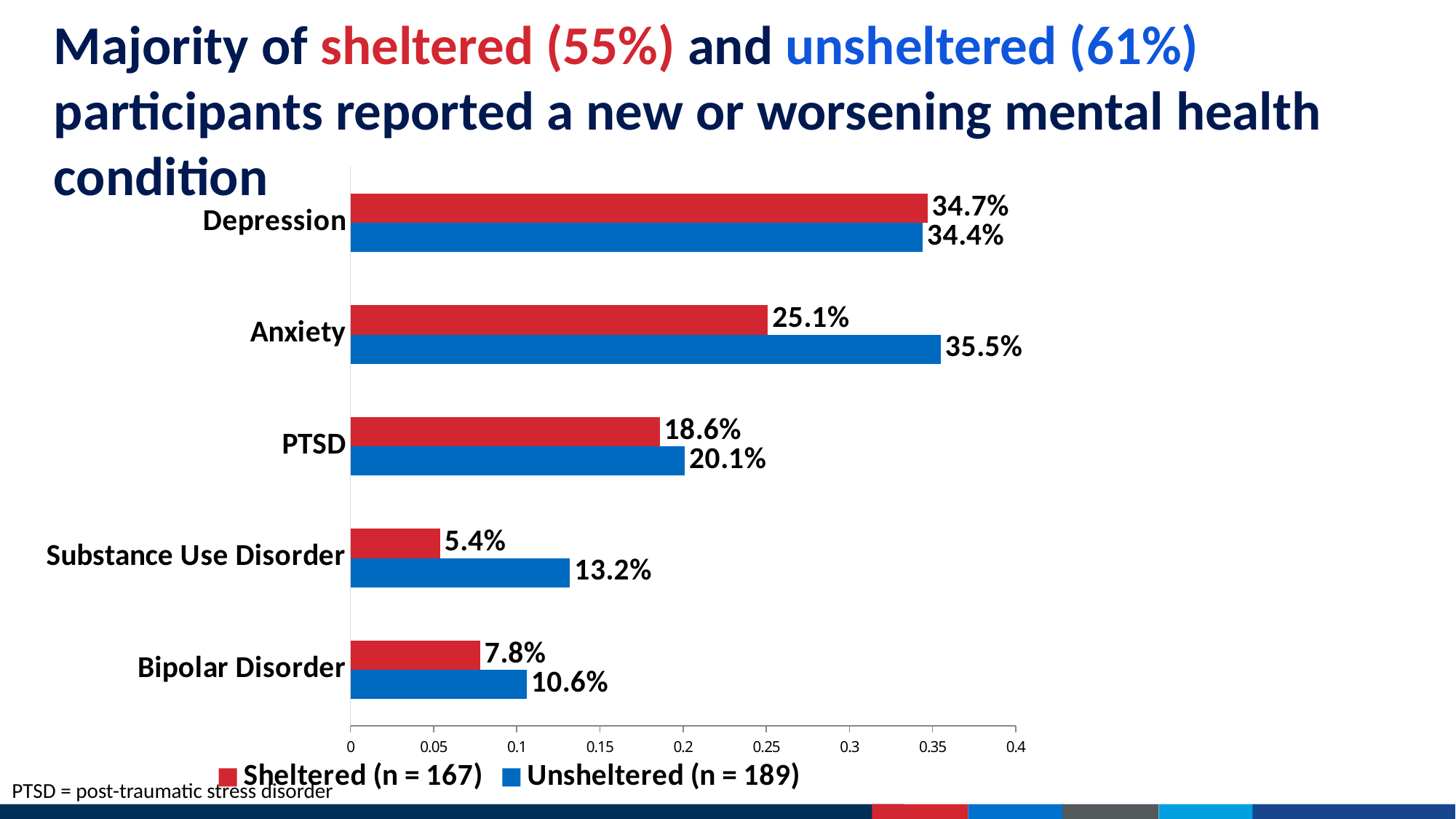
What kind of chart is shown on the slide? Bar chart Which condition has the lowest value among sheltered participants? Substance Use Disorder Which is larger for PTSD: the sheltered value or the unsheltered value? Unsheltered What percentage of unsheltered participants reported anxiety? 35.5% What is the value for Substance Use Disorder in the Unsheltered series? 13.2% What percentage of sheltered participants reported depression? 34.7% Which condition has the highest value among unsheltered participants? Anxiety What is the difference between the unsheltered and sheltered values for Anxiety? 10.4% How many series does the legend list? 2 What is the value for Bipolar Disorder in the Sheltered series? 7.8% Which condition has the highest value among sheltered participants? Depression How many mental health conditions are shown on the chart? 5